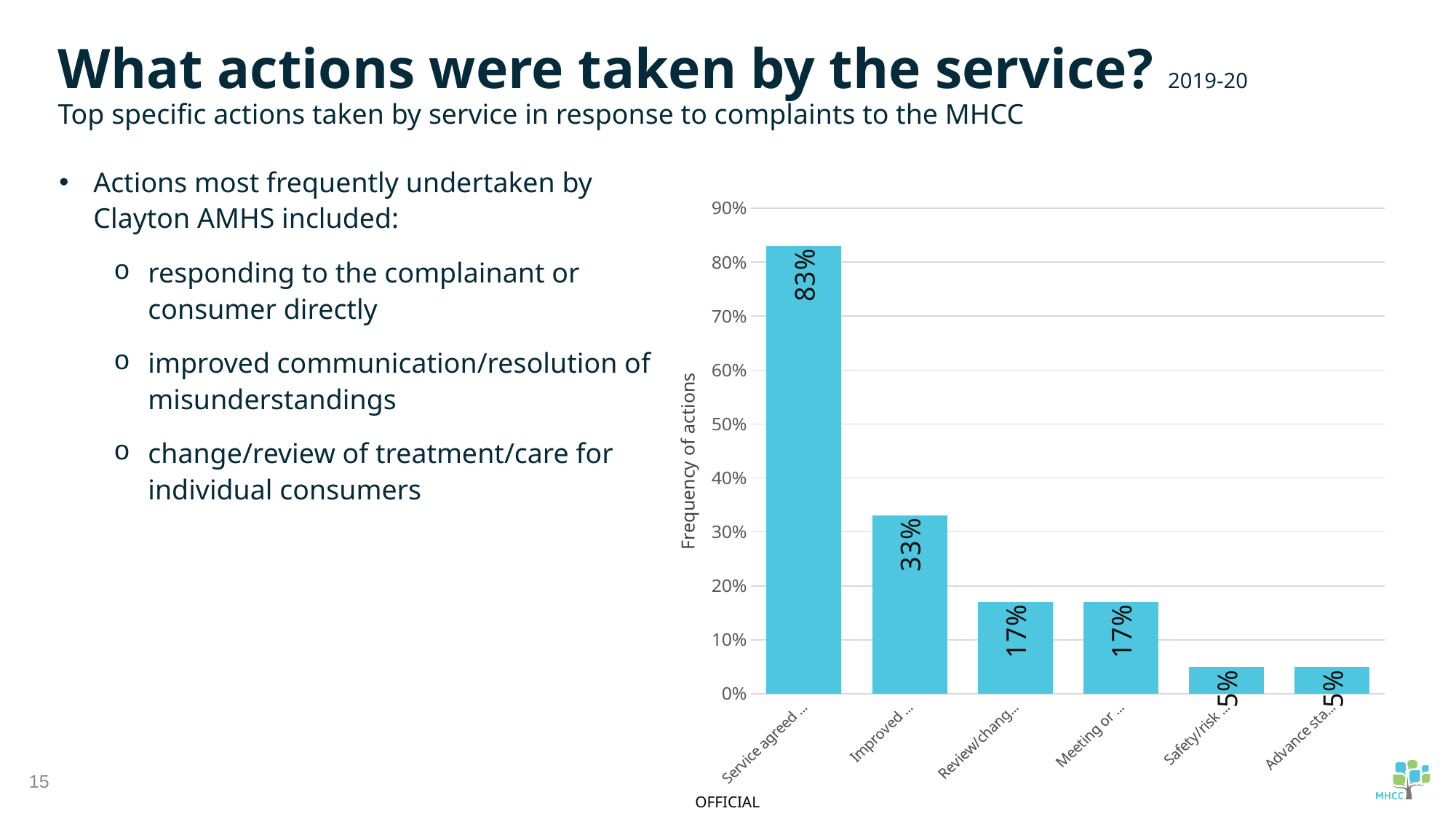
Do the values rise or fall from left to right along the x axis? Fall Which category has the highest frequency of actions? Service agreed ... (the first bar) What value is shown for the first bar, labelled "Service agreed ..."? 83% What is the difference in percentage points between the "Improved ..." bar and the "Meeting or ..." bar? 16 percentage points What value is shown for the bar labelled "Safety/risk ..."? 5% How many bars are plotted in the chart? 6 What value is shown for the bar labelled "Improved ..."? 33% Is the value for "Meeting or ..." greater or less than 20%? less Which is larger, the value for "Improved ..." or the value for "Meeting or ..."? Improved ... What is the difference in percentage points between the "Service agreed ..." bar and the "Improved ..." bar? 50 percentage points What value is shown for the bar labelled "Review/chang..."? 17% What type of chart is shown on the slide? Bar chart